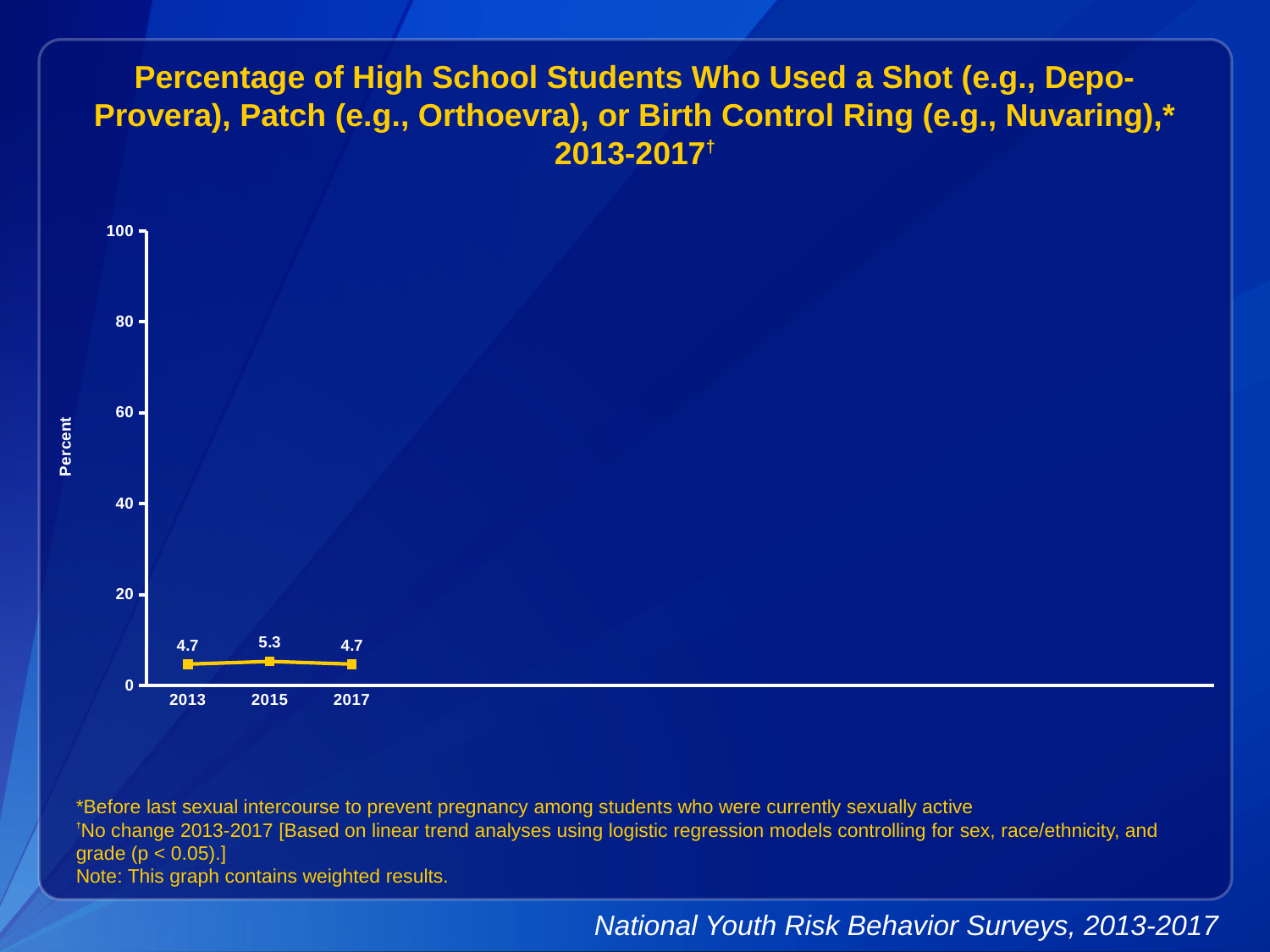
What is the difference between the values for 2015 and 2013? 0.6 Which is larger, the value for 2015 or the value for 2017? 2015 What is the maximum value shown on the y axis? 100 What is the value for 2017? 4.7 How many years are plotted on the chart? 3 Does the value rise or fall from 2013 to 2015? rise Which year has the highest value? 2015 What kind of chart is shown on the slide? line chart What is the value for 2013? 4.7 What is the value for 2015? 5.3 What is the label on the y axis? Percent Is the value for 2015 greater or less than 20? less